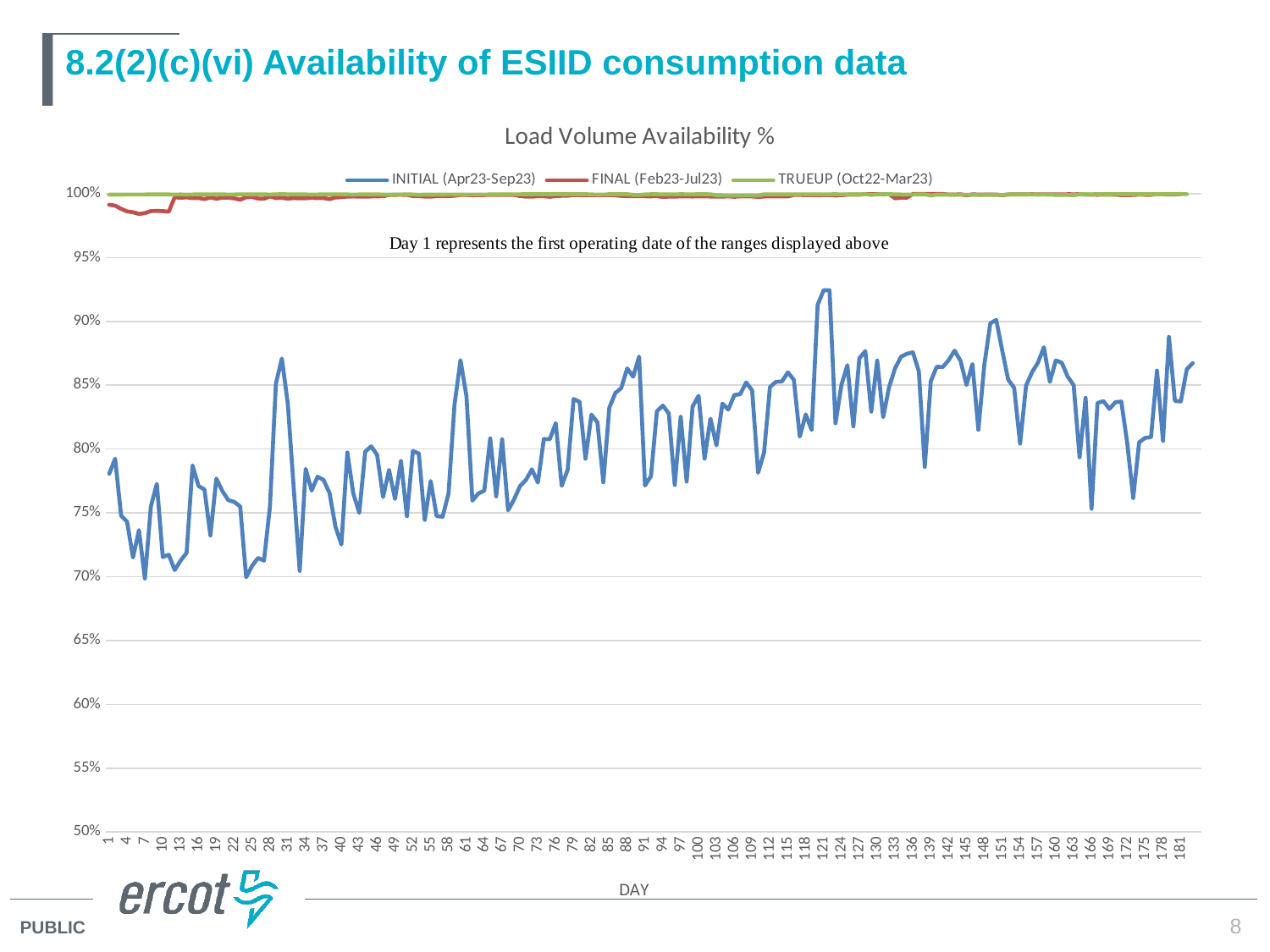
What kind of chart is shown on the slide? line chart Does the INITIAL (Apr23-Sep23) series generally rise or fall from day 1 to day 181? rise Is the value of the FINAL (Feb23-Jul23) series at day 1 greater or less than 95%? greater Which series has the lowest values across the chart? INITIAL (Apr23-Sep23) At day 100, which series has the larger value, INITIAL (Apr23-Sep23) or TRUEUP (Oct22-Mar23)? TRUEUP (Oct22-Mar23) Which colour is used for the INITIAL (Apr23-Sep23) series? blue Is the value of the INITIAL (Apr23-Sep23) series at day 121 greater or less than 90%? greater Is the value of the INITIAL (Apr23-Sep23) series at day 1 greater or less than 75%? greater What is the title of the chart? Load Volume Availability % How many series does the legend list? 3